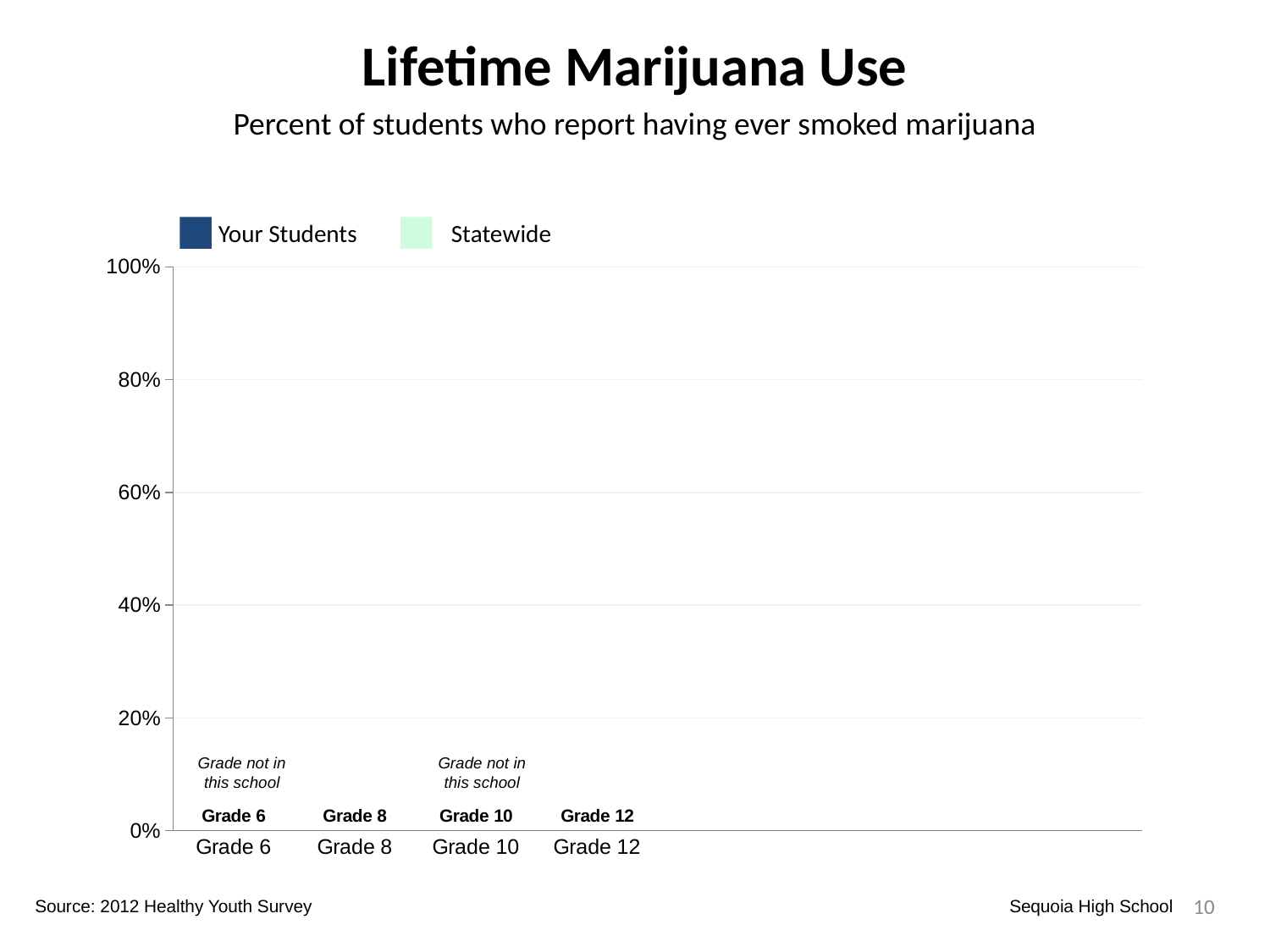
How many grade categories are shown on the x axis of the chart? 4 What are the two series named in the chart's legend? Your Students and Statewide How many series does the chart's legend list? 2 What is the lowest value shown on the chart's y axis? 0% What is the highest value shown on the chart's y axis? 100% Which grades are marked as "Grade not in this school" on the chart? Grade 6 and Grade 10 What is the title of the chart? Lifetime Marijuana Use